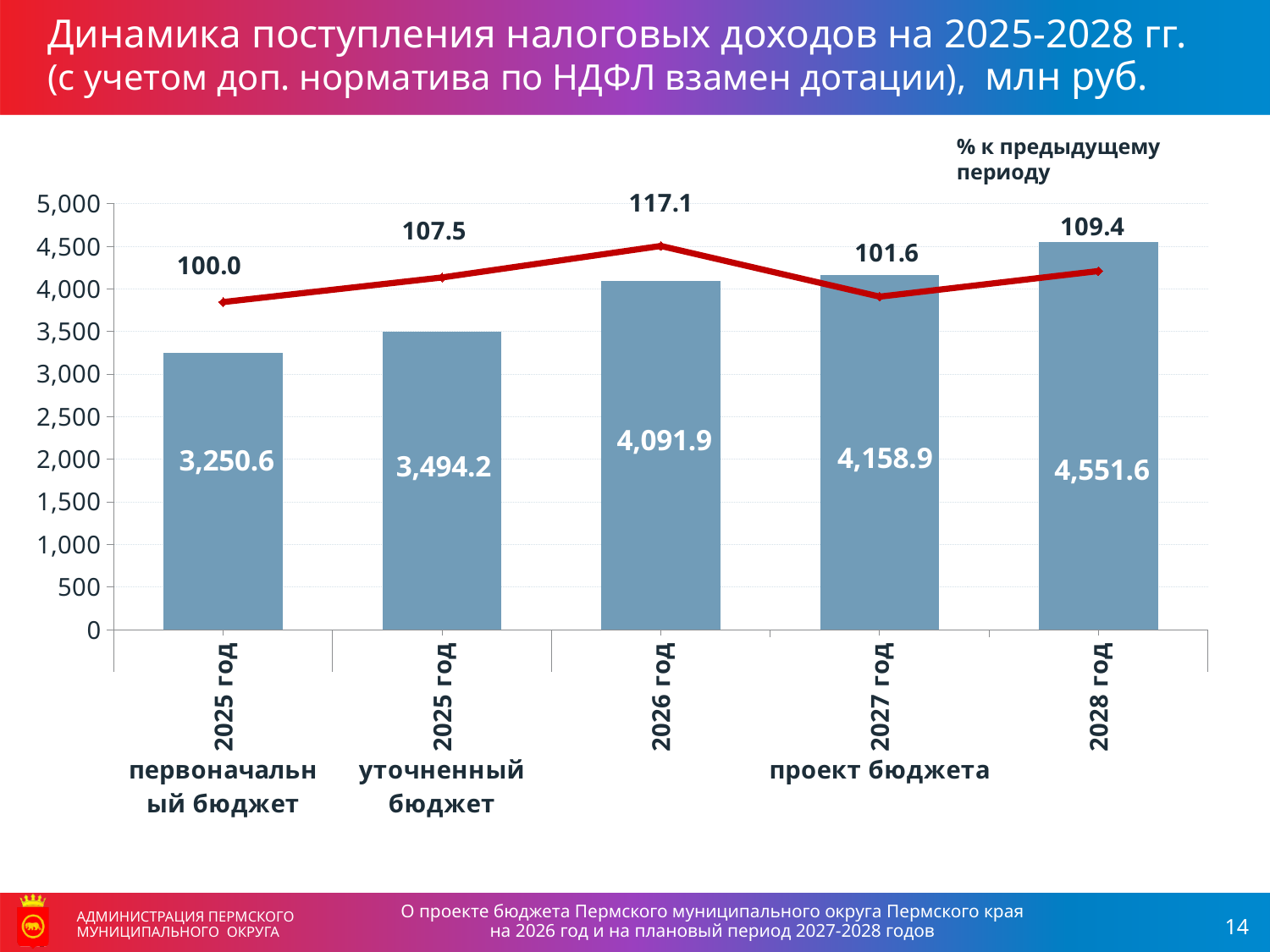
What is the bar value for 2025 год (уточненный бюджет)? 3,494.2 What is the difference between the bar values for 2028 год and 2027 год? 392.7 How many bars are plotted in the chart? 5 What is the tax revenue value shown for 2028 год? 4,551.6 Which category has the lowest bar value? 2025 год (первоначальный бюджет) What is the '% к предыдущему периоду' value shown for 2026 год? 117.1 What is the highest '% к предыдущему периоду' value on the line? 117.1 Which category has the highest bar value? 2028 год Which is larger: the bar value for 2026 год or for 2027 год? 2027 год What is the '% к предыдущему периоду' value shown for 2027 год? 101.6 What is the bar value for 2025 год (первоначальный бюджет)? 3,250.6 Do the bar values rise or fall from left to right across the categories? rise